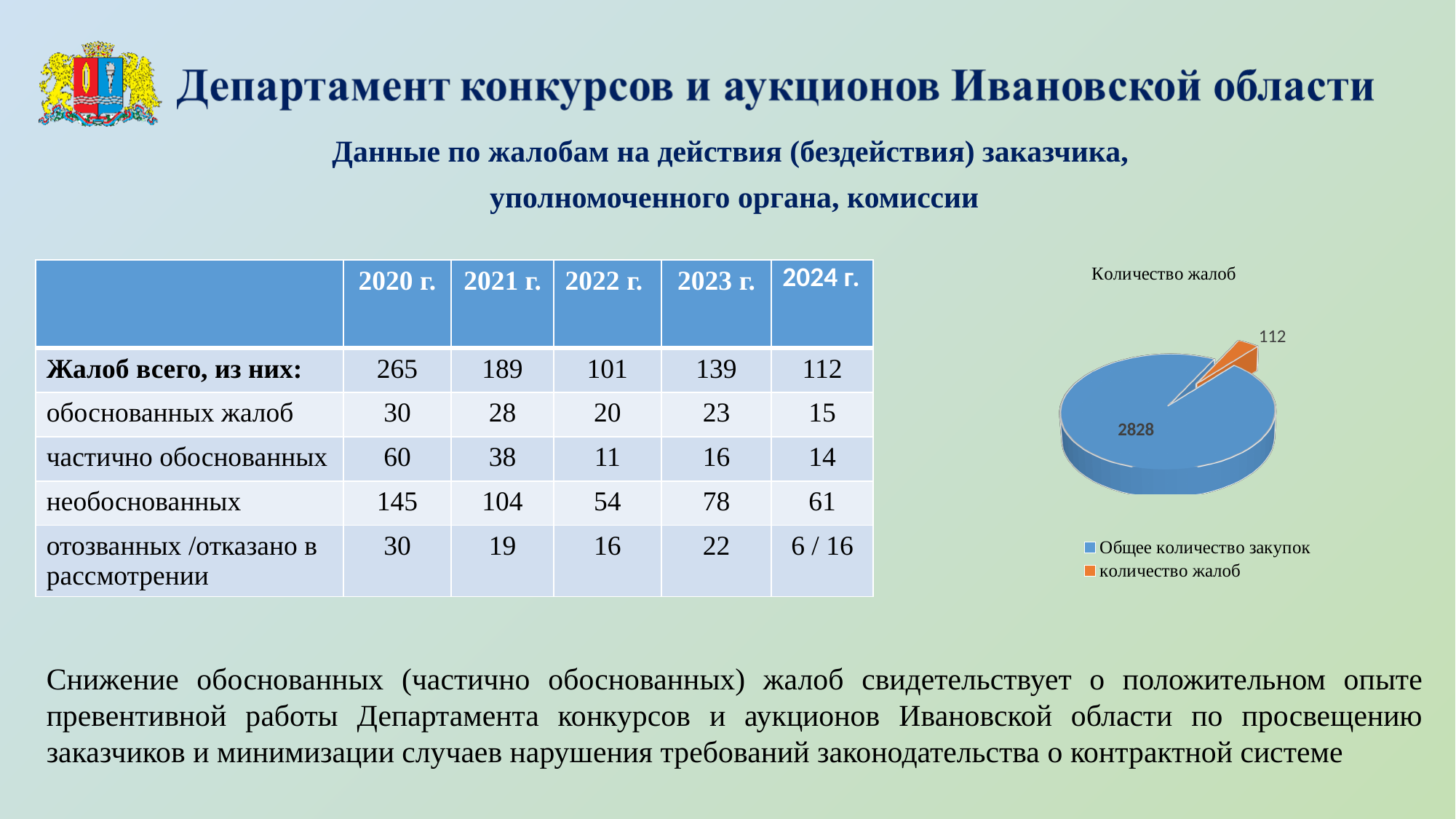
In the pie chart, what is the value for "количество жалоб"? 112 Which slice of the pie chart is the smallest? количество жалоб What is the title of the pie chart? Количество жалоб What colour is the "количество жалоб" slice in the pie chart? Orange In the pie chart, which is larger: "Общее количество закупок" or "количество жалоб"? Общее количество закупок What is the sum of the two values shown in the pie chart? 2940 Which slice of the pie chart is the largest? Общее количество закупок How many entries does the legend of the pie chart list? 2 In the pie chart, what is the difference between the value for "Общее количество закупок" and the value for "количество жалоб"? 2716 What kind of chart is shown on the right side of the slide? Pie chart How many slices does the pie chart have? 2 In the pie chart, what is the value for "Общее количество закупок"? 2828